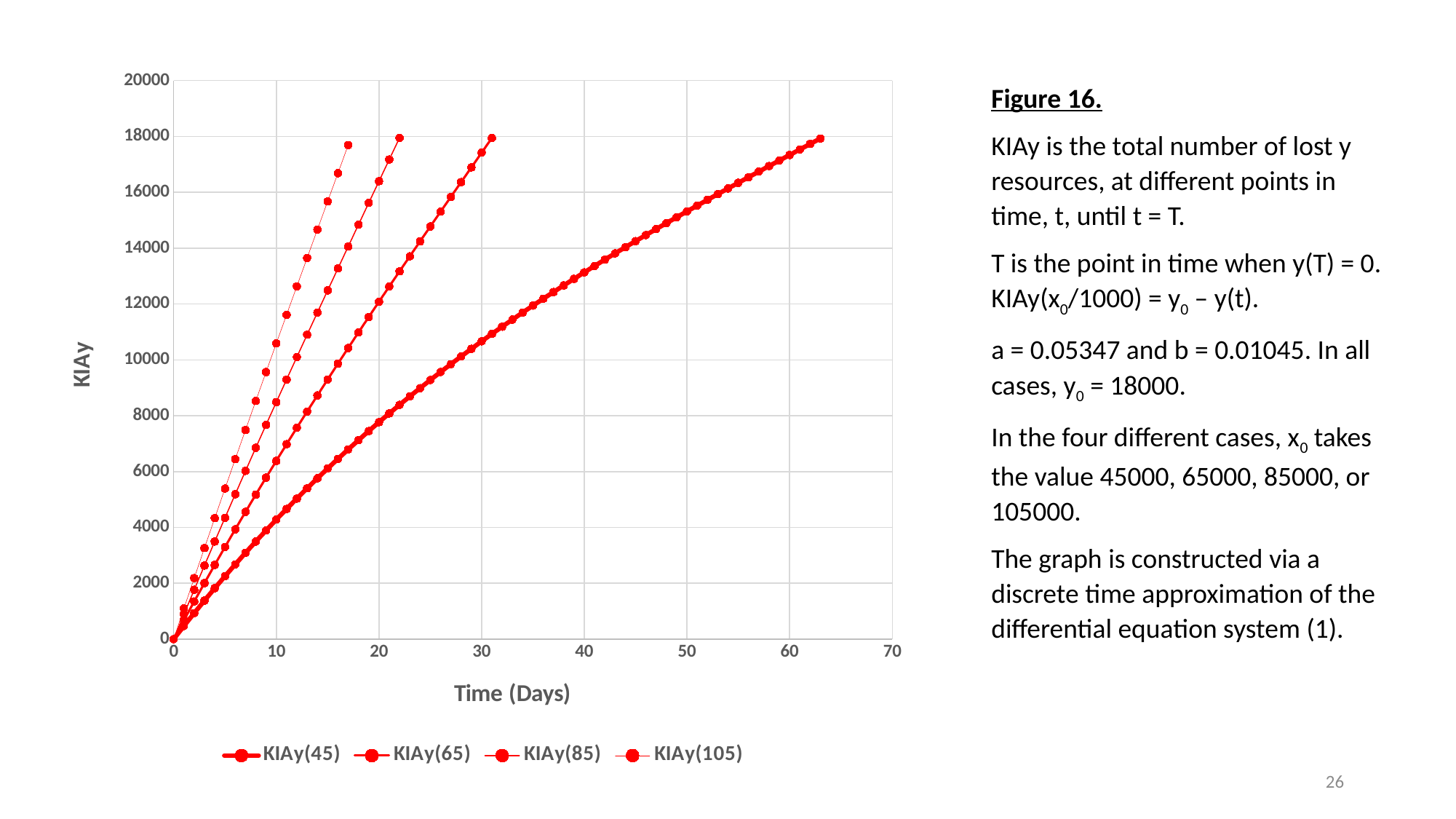
What is the title of the x axis? Time (Days) Is the value of KIAy(45) at day 10 greater or less than 6000? less What kind of chart is shown on the slide? line chart Do the KIAy values rise or fall as time increases? rise How many series does the legend list? 4 At day 20, which series has the larger value, KIAy(45) or KIAy(65)? KIAy(65) Which series reaches about 18000 in the fewest days? KIAy(105) What is the highest tick value shown on the y axis? 20000 Is the value of KIAy(45) at day 50 greater or less than 14000? greater Which series extends furthest along the time axis before ending? KIAy(45)